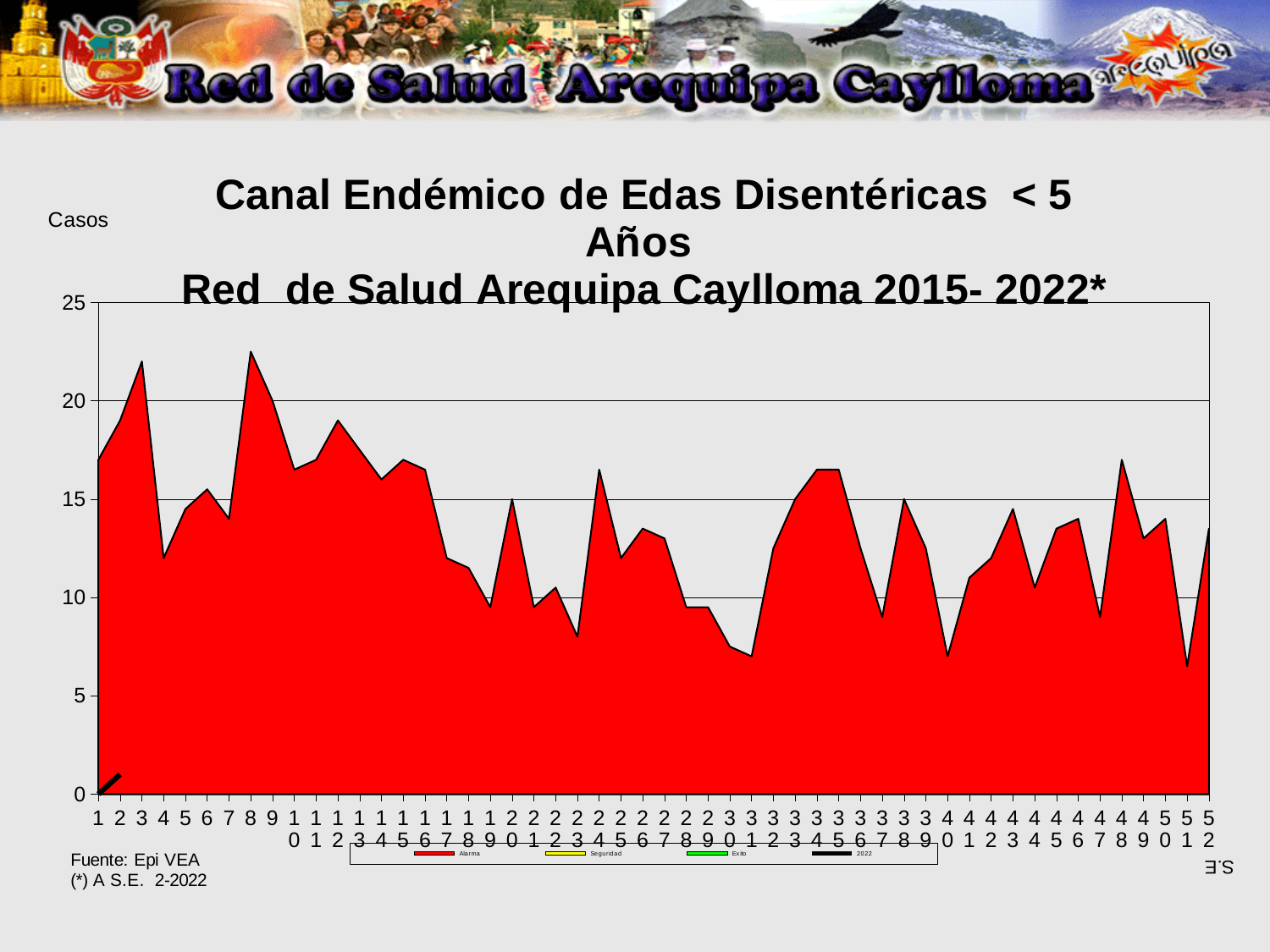
Is the value for week 30 greater or less than 10? less Is the value for week 51 greater or less than 10? less How many entries does the chart legend list? 4 How many weeks (points) are shown along the x axis? 52 What label is shown on the vertical axis of the chart? Casos Do the values rise or fall from week 1 to week 3? Rise Which week has the larger value, week 3 or week 4? Week 3 Is the value for week 4 greater or less than 15? less What is the title of the chart? Canal Endémico de Edas Disentéricas < 5 Años Red de Salud Arequipa Caylloma 2015- 2022* What kind of chart is shown on the slide? Area chart